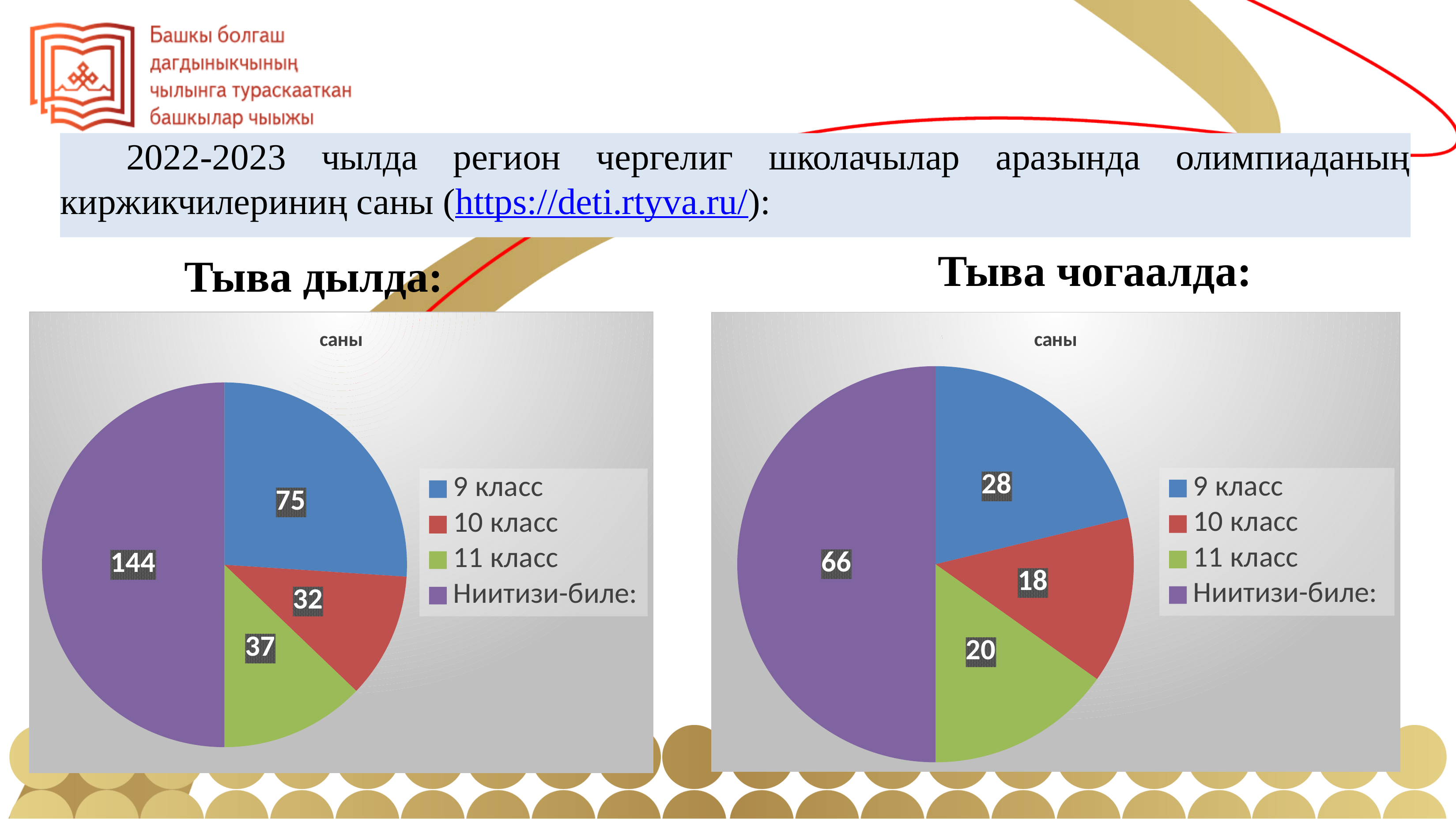
In the left pie chart (Тыва дылда), which category has the smallest slice? 10 класс How many slices does the left pie chart (Тыва дылда) have? 4 What type of chart is used for Тыва чогаалда? Pie chart In the right pie chart (Тыва чогаалда), what is the value for Ниитизи-биле:? 66 What is the title shown inside both charts? саны In the left pie chart (Тыва дылда), what is the value for 9 класс? 75 In the right pie chart (Тыва чогаалда), what is the difference between the values for 9 класс and 11 класс? 8 In the right pie chart (Тыва чогаалда), what is the value for 10 класс? 18 In the left pie chart (Тыва дылда), what is the value for 11 класс? 37 In the left pie chart (Тыва дылда), what is the difference between the values for 9 класс and 10 класс? 43 In the right pie chart (Тыва чогаалда), which is larger: the value for 11 класс or the value for 10 класс? 11 класс In the right pie chart (Тыва чогаалда), which category has the largest slice? Ниитизи-биле: